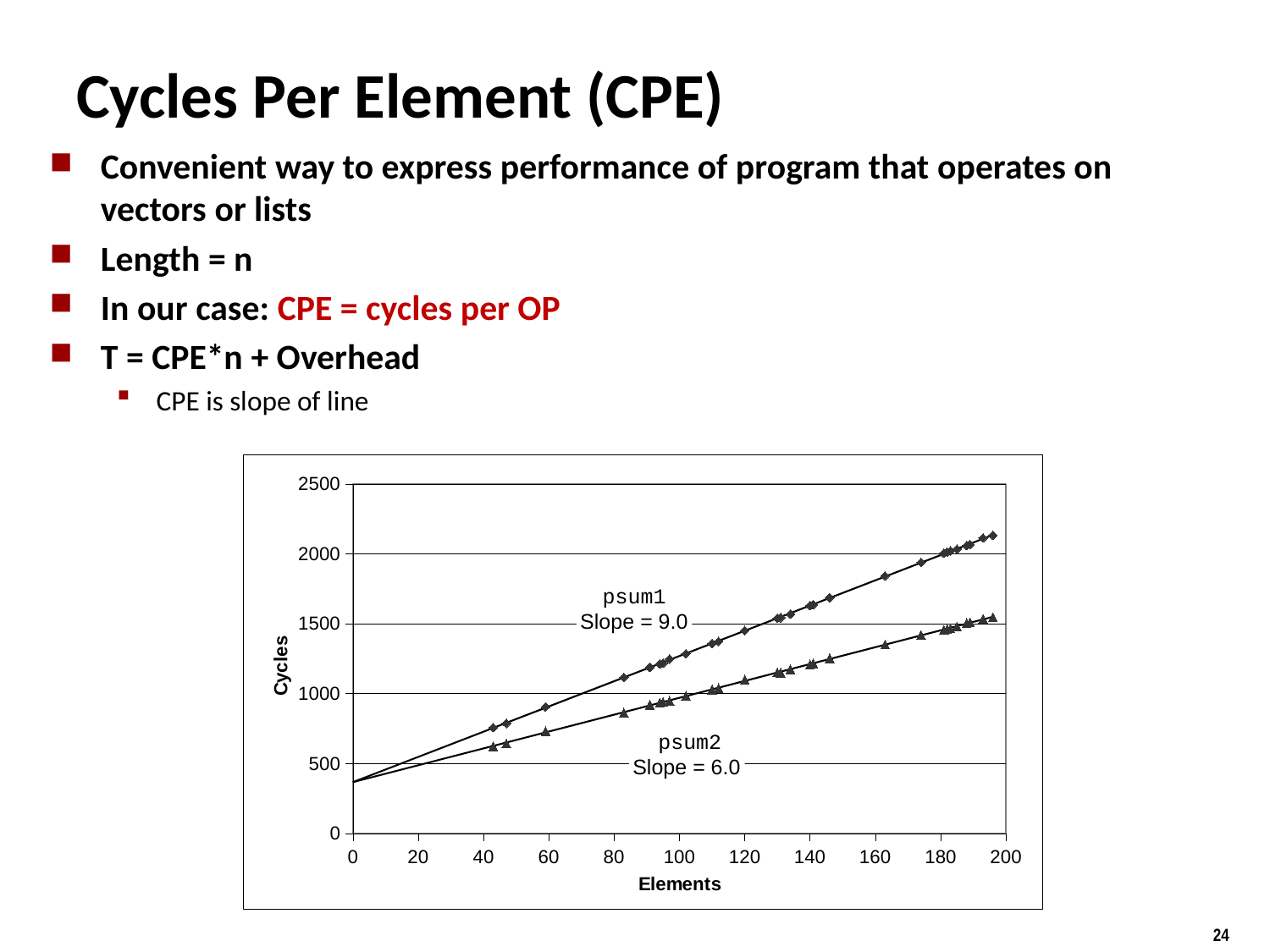
Is the value for psum1 at about 190 elements greater or less than 2000 cycles? greater What is the difference between the slope of psum1 and the slope of psum2? 3.0 What is the slope shown for the psum1 line? 9.0 How many data series are plotted on the chart? 2 What is the slope shown for the psum2 line? 6.0 At 150 elements, which series has more cycles, psum1 or psum2? psum1 Do the cycles for psum2 rise or fall as the number of elements increases? rise Is the value for psum1 at about 60 elements greater or less than 1000 cycles? less Which series has the steeper slope, psum1 or psum2? psum1 What is the title of the x axis of the chart? Elements What is the title of the y axis of the chart? Cycles